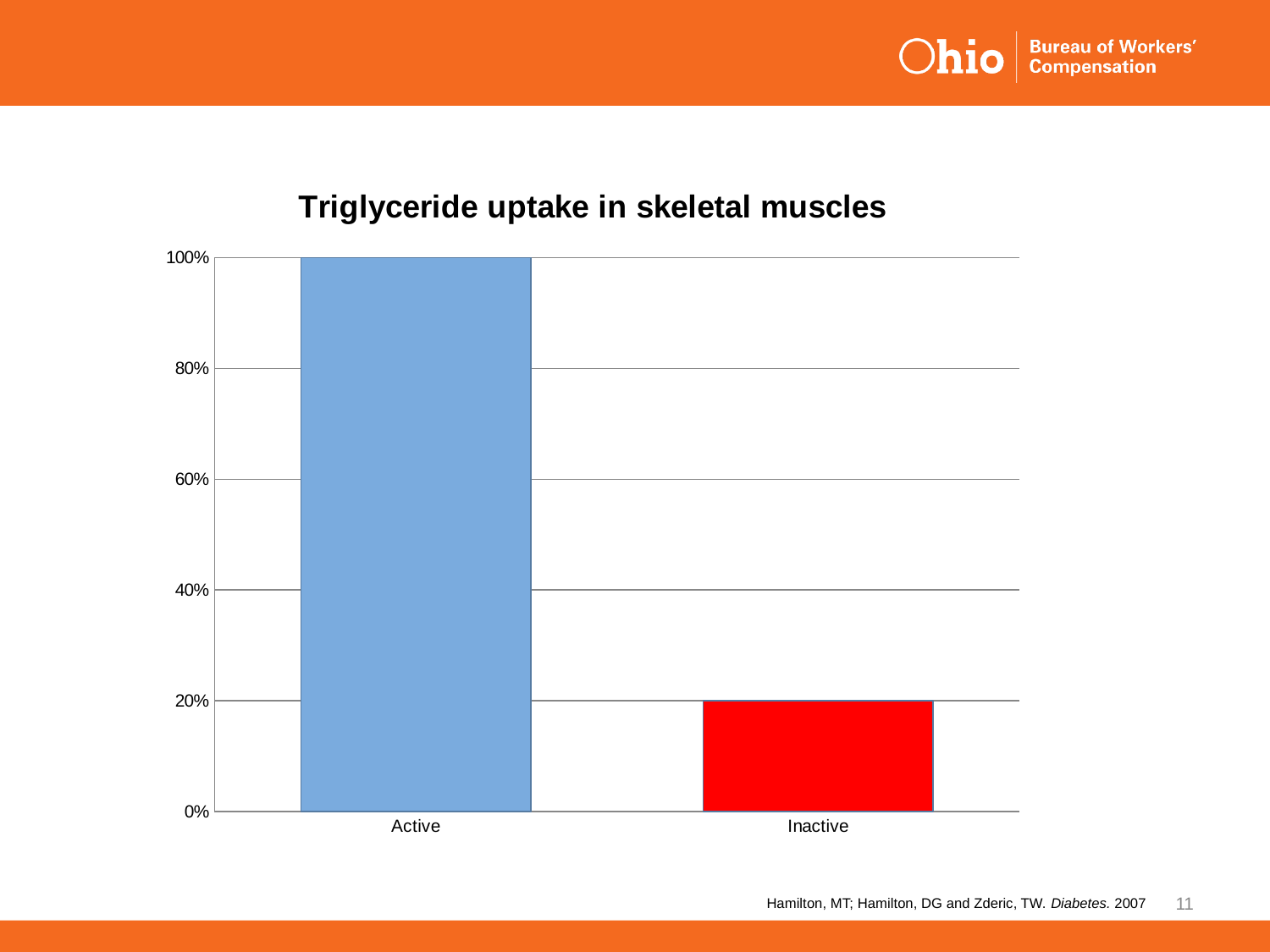
Is the value for Active greater or less than 60%? greater What colour is the bar for Inactive? red How many categories are plotted on the x axis? 2 Which category has the highest value? Active Which is larger, the value for Active or the value for Inactive? Active Which category has the lowest value? Inactive What is the title of the chart? Triglyceride uptake in skeletal muscles Is the value for Inactive greater or less than 40%? less What is the value for Active? 100% What is the difference between the value for Active and the value for Inactive? 80% What type of chart is shown on the slide? bar chart What is the value for Inactive? 20%